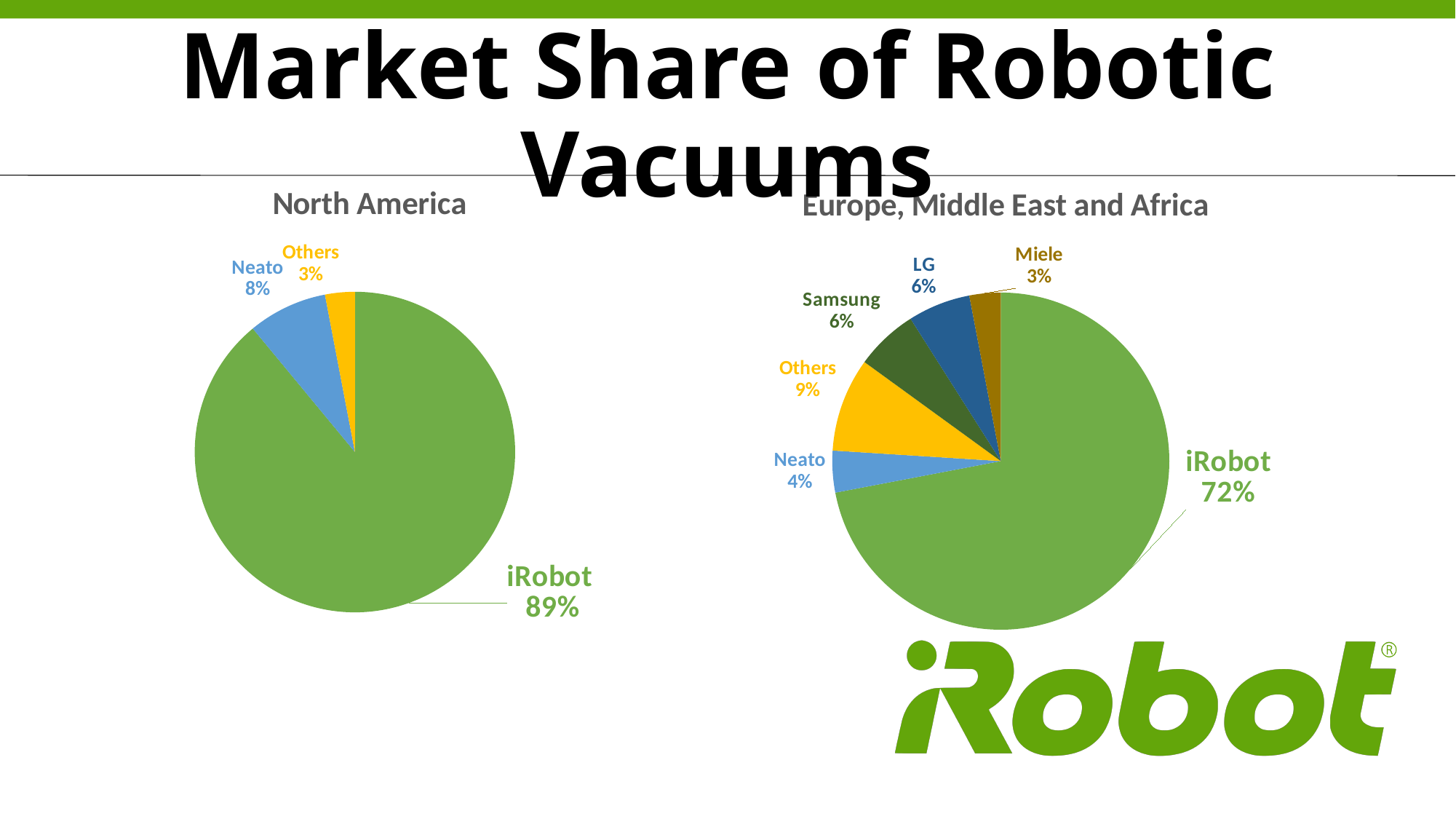
What is the difference between iRobot's share in North America and its share in Europe, Middle East and Africa? 17% In the Europe, Middle East and Africa chart, what is the share for Others? 9% In the Europe, Middle East and Africa chart, which is larger, Neato's share or Samsung's share? Samsung How many slices does the Europe, Middle East and Africa pie chart have? 6 How many slices does the North America pie chart have? 3 What type of chart is used for the North America data? Pie chart In the North America chart, what is iRobot's market share? 89% In the North America chart, which category has the smallest share? Others In the North America chart, what is Neato's market share? 8% In the Europe, Middle East and Africa chart, what is iRobot's market share? 72% In the Europe, Middle East and Africa chart, what is Miele's market share? 3% In the Europe, Middle East and Africa chart, which company has the largest share? iRobot